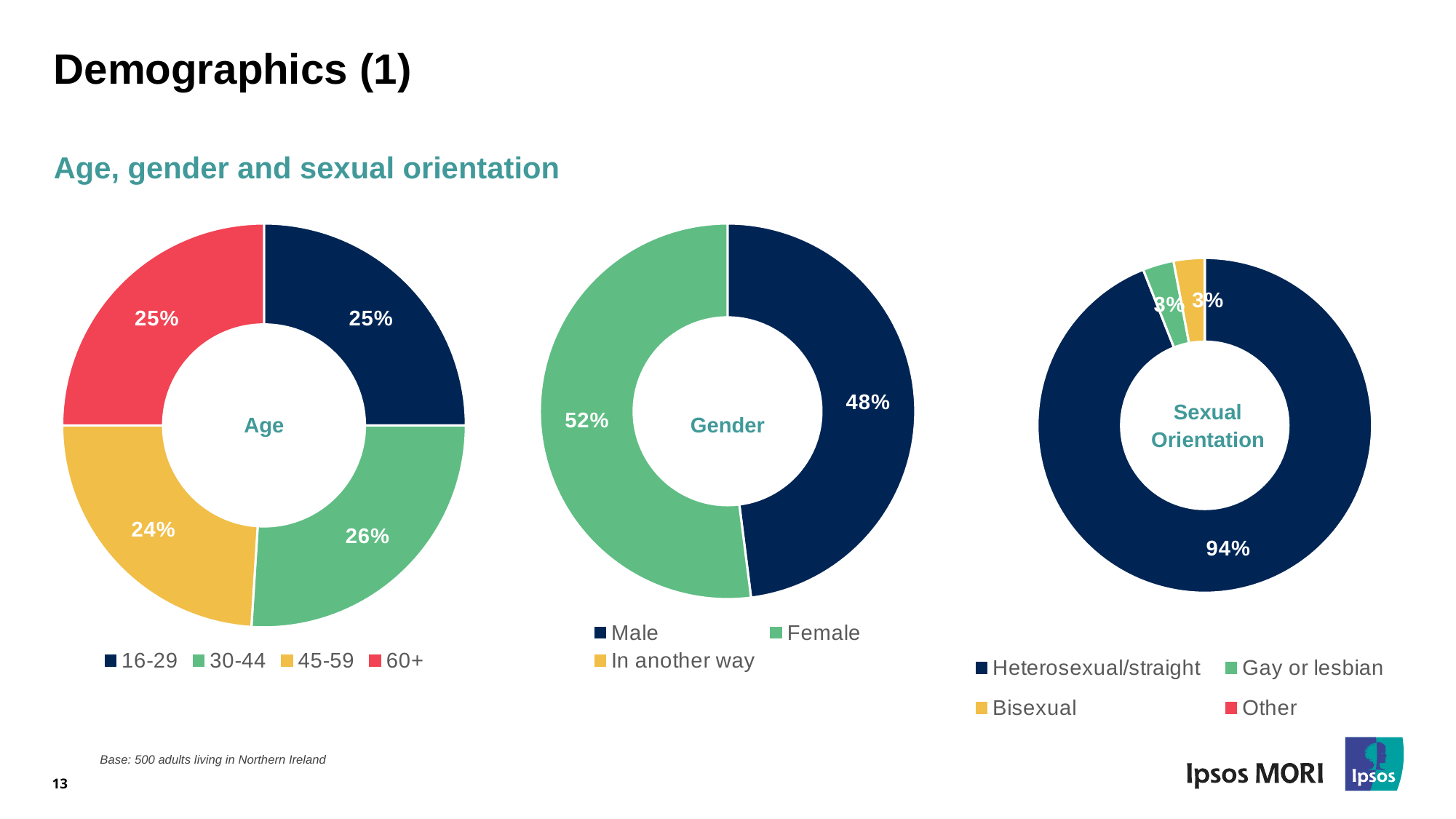
In the Sexual Orientation chart, what percentage is shown for Bisexual? 3% In the Age chart, which age group has the smallest share? 45-59 In the Gender chart, what is the difference between the Female and Male shares? 4% What kind of chart is the Age chart? Donut (pie) chart In the Gender chart, what percentage is shown for Female? 52% In the Gender chart, which is larger, Male or Female? Female How many categories does the legend of the Sexual Orientation chart list? 4 In the Age chart, which age group has the largest share? 30-44 In the Age chart, what percentage is shown for the 45-59 group? 24% In the Age chart, what percentage is shown for the 30-44 group? 26% In the Sexual Orientation chart, what percentage is shown for Heterosexual/straight? 94% In the Age chart, what is the difference between the 30-44 share and the 45-59 share? 2%